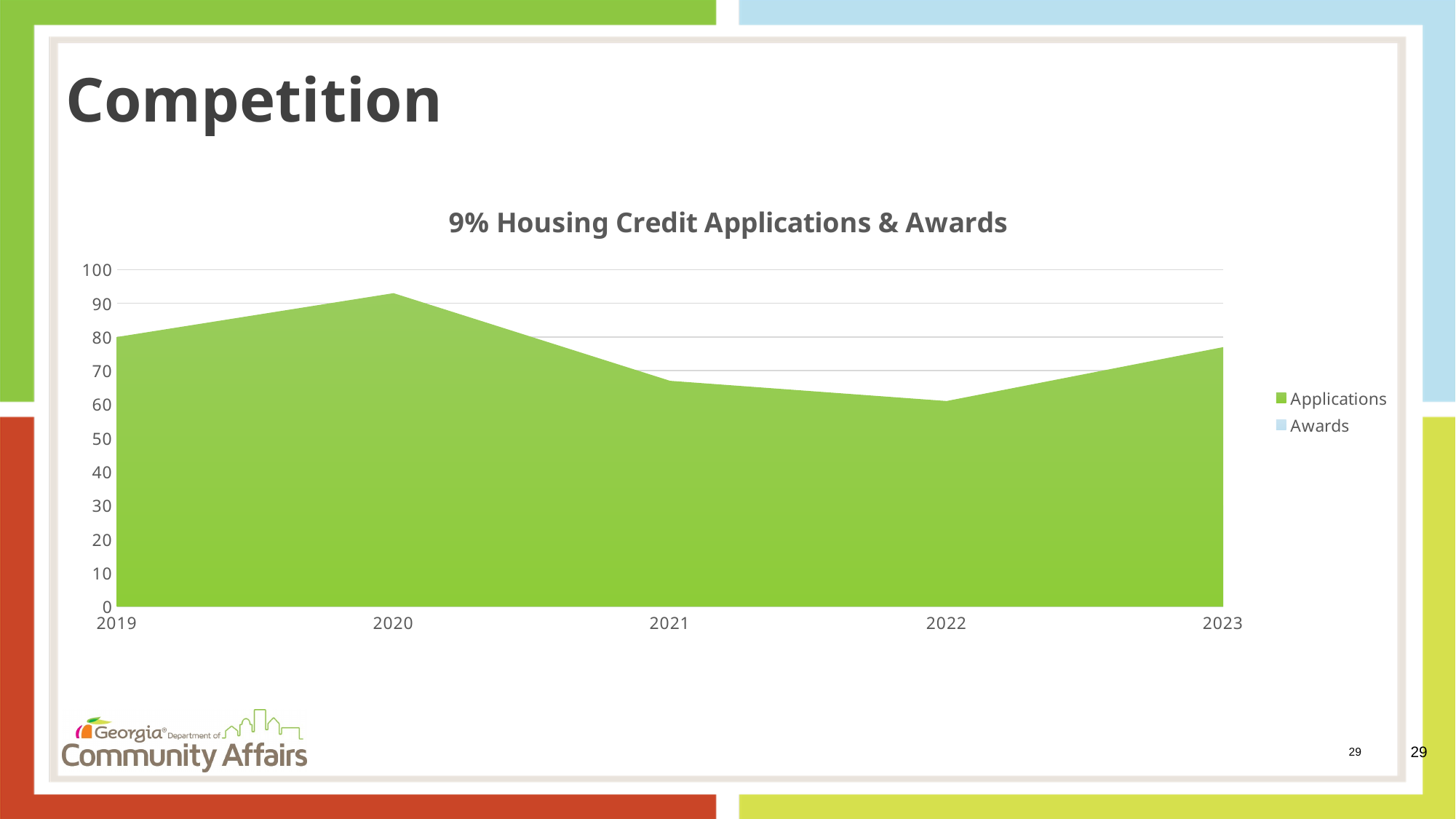
How many series does the legend list? 2 In which year is the number of Applications lowest? 2022 Is the value for Applications in 2020 greater or less than 80? greater What kind of chart is shown on the slide? Area chart Do Applications rise or fall from 2020 to 2022? Fall What is the title of the chart? 9% Housing Credit Applications & Awards How many years are shown on the x axis? 5 Is the value for Applications in 2022 greater or less than 70? less Is the value for Applications in 2021 greater or less than 80? less Which series is shown in green in the legend? Applications In which year is the number of Applications highest? 2020 Which year has more Applications, 2019 or 2021? 2019